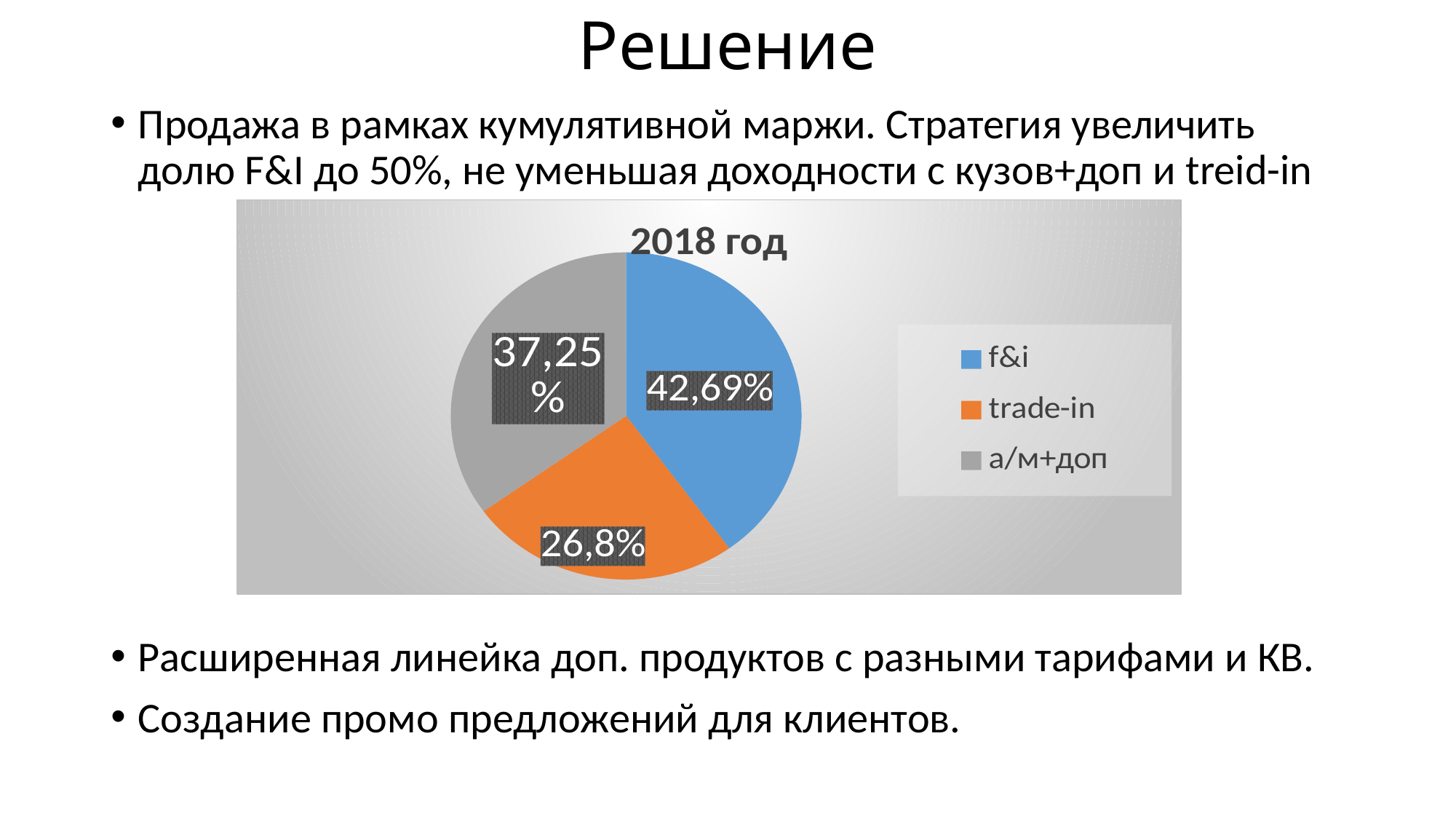
What is the value shown for the f&i slice? 42,69% Which is larger, the f&i slice or the а/м+доп slice? f&i What colour is the trade-in slice in the pie chart? orange How many slices does the pie chart have? 3 What is the difference between the f&i share and the trade-in share? 15,89% What is the title of the chart? 2018 год What is the value shown for the а/м+доп slice? 37,25% What is the difference between the а/м+доп share and the trade-in share? 10,45% Which category has the largest slice of the pie? f&i Which category has the smallest slice of the pie? trade-in What kind of chart is shown on the slide? pie chart What is the value shown for the trade-in slice? 26,8%